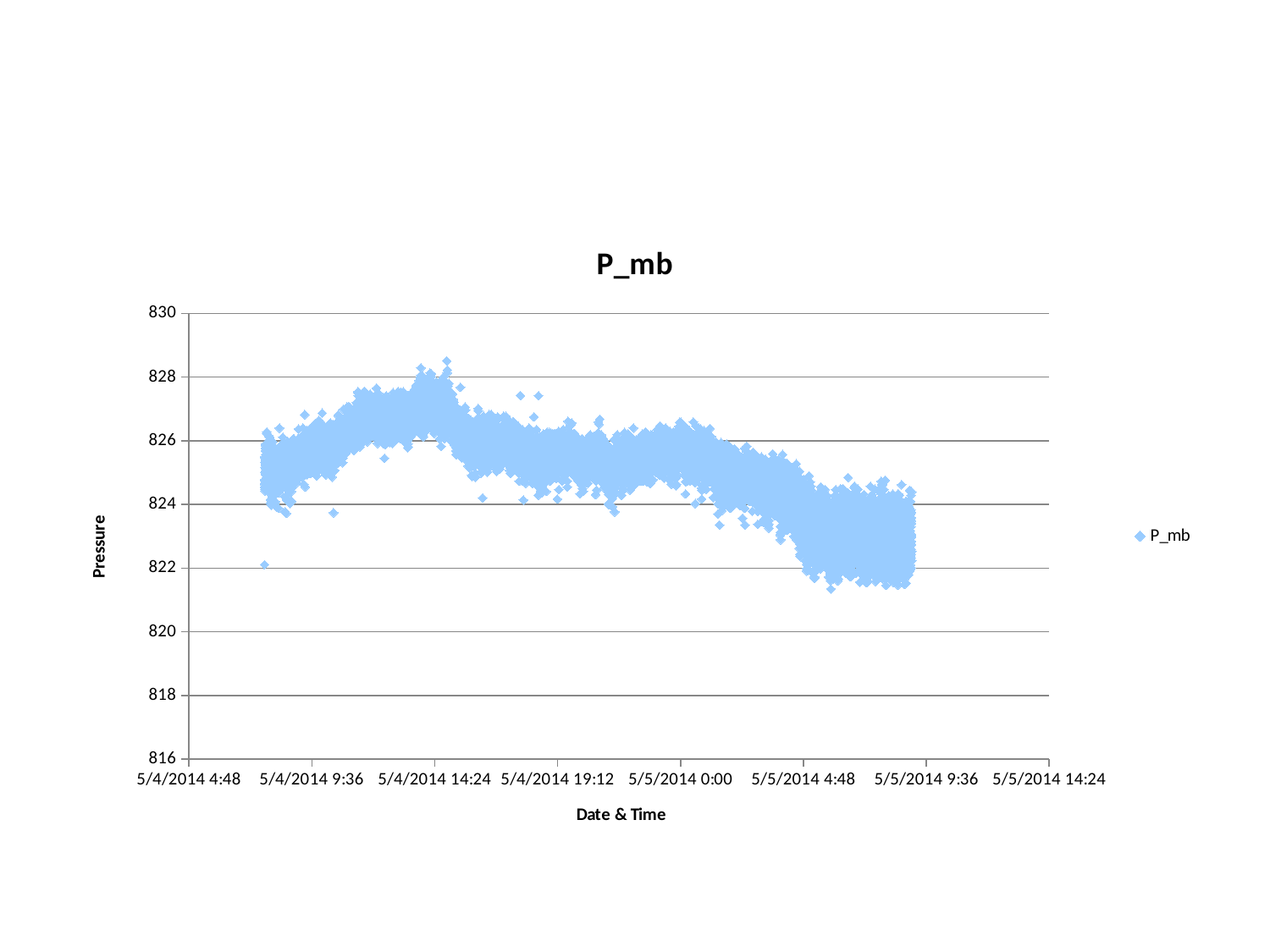
Are the pressure values around 5/5/2014 9:36 greater or less than 820? greater Are the pressure values around 5/4/2014 14:24 greater or less than 826? greater Are the pressure values around 5/5/2014 0:00 greater or less than 824? greater Which time period has higher pressure values: around 5/4/2014 14:24 or around 5/5/2014 4:48? around 5/4/2014 14:24 How many series does the legend list? 1 What kind of chart is shown on the slide? scatter chart What is the label of the vertical axis? Pressure What is the lowest value shown on the vertical axis? 816 What is the title of the chart? P_mb Do the pressure values generally rise or fall between 5/4/2014 14:24 and 5/5/2014 9:36? fall